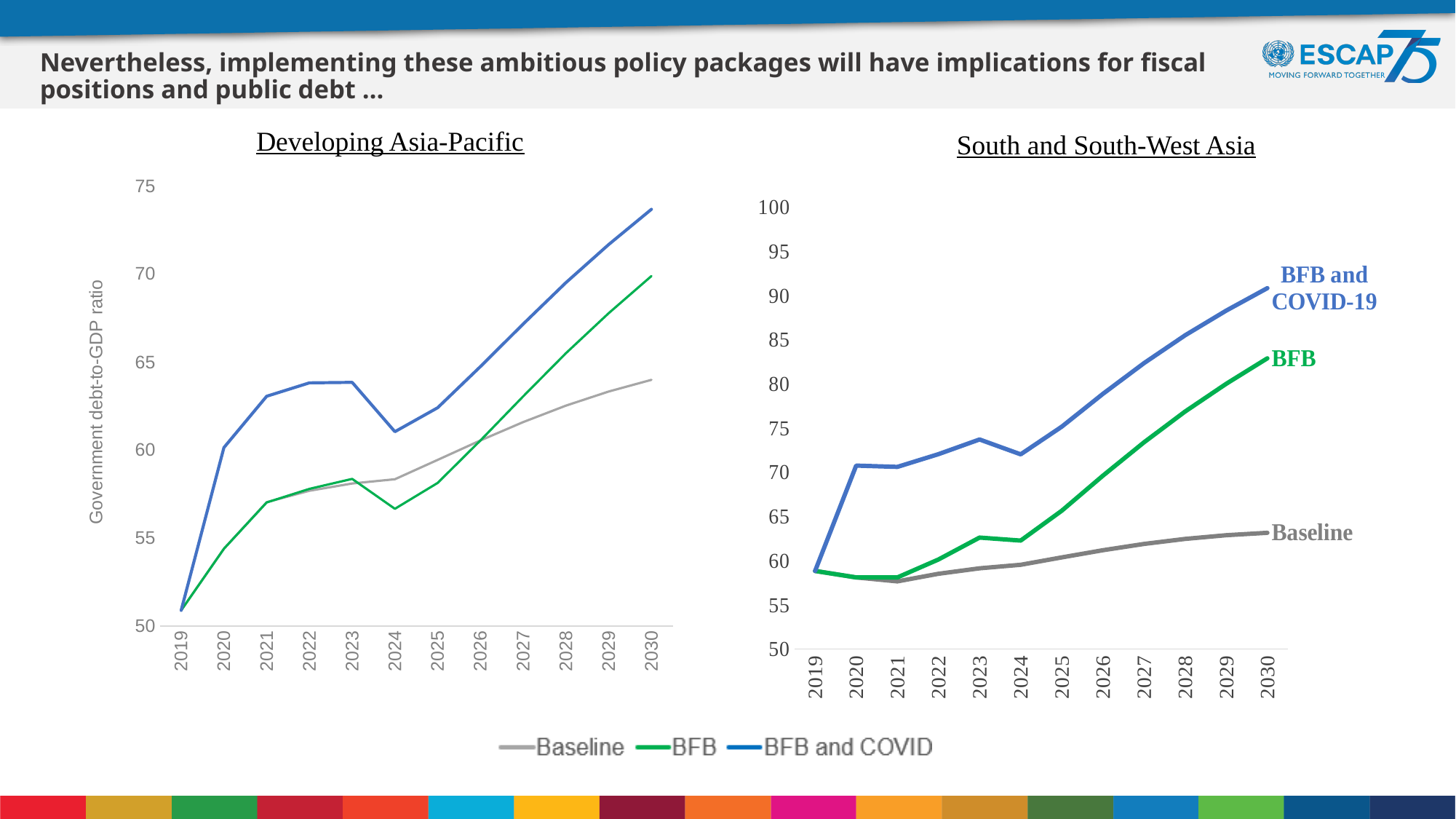
In the "Developing Asia-Pacific" chart, is the value for BFB and COVID in 2030 greater or less than 70? greater How many years are shown on the x axis of the "South and South-West Asia" chart? 12 In the "Developing Asia-Pacific" chart, which series has the highest value in 2030? BFB and COVID What is the y-axis label of the "Developing Asia-Pacific" chart? Government debt-to-GDP ratio How many series does the legend list for the charts on the slide? 3 In the "South and South-West Asia" chart, does the Baseline series generally rise or fall from 2021 to 2030? rise In the "Developing Asia-Pacific" chart, which is larger in 2024: the Baseline value or the BFB value? Baseline In the "South and South-West Asia" chart, which is larger in 2020: the BFB and COVID-19 value or the BFB value? BFB and COVID-19 In the "South and South-West Asia" chart, is the BFB value in 2030 greater or less than 80? greater In the "South and South-West Asia" chart, which series has the lowest value in 2030? Baseline In the "South and South-West Asia" chart, is the Baseline value in 2030 greater or less than 65? less What kind of chart is the "Developing Asia-Pacific" chart? line chart